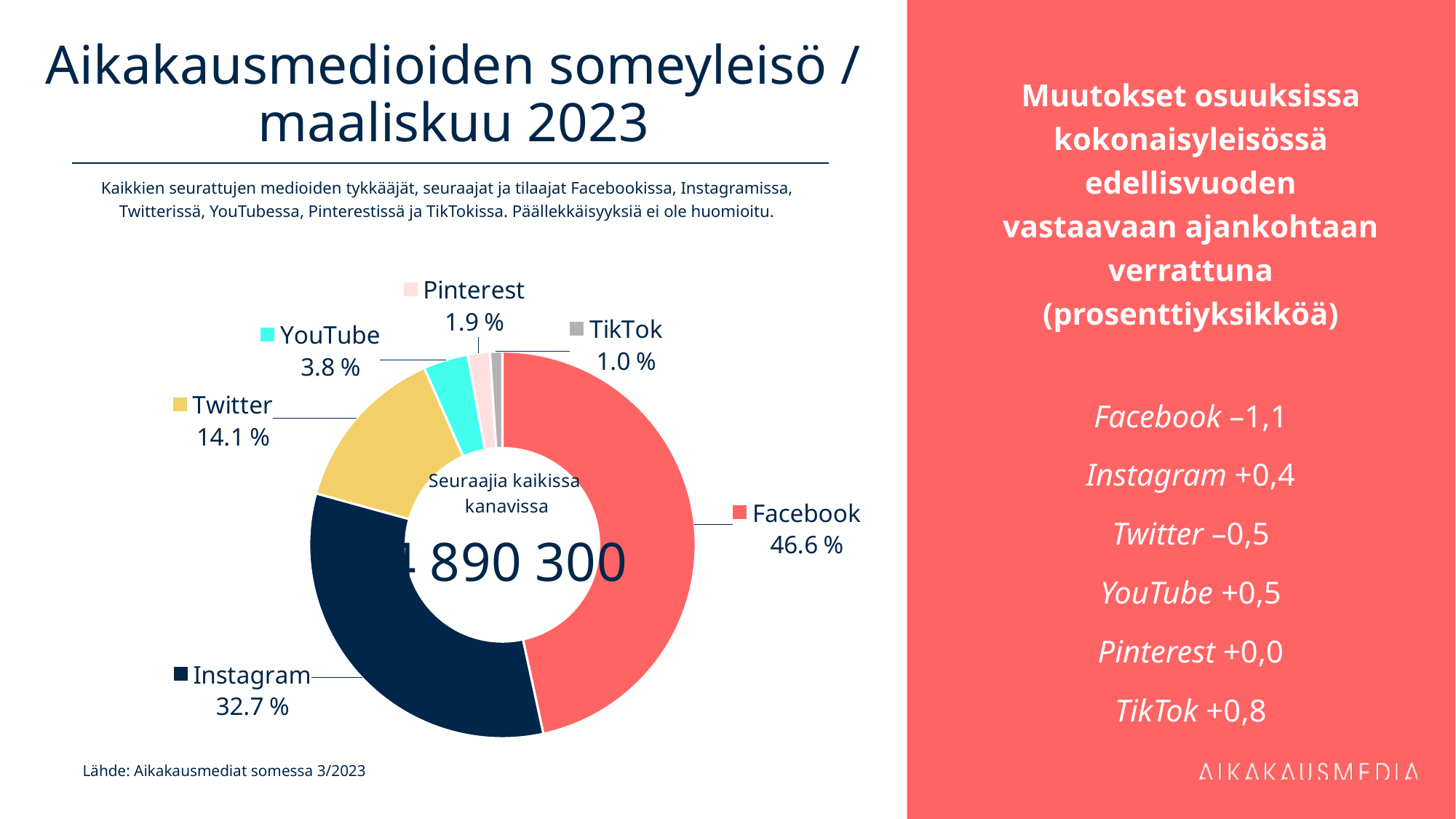
What is the value shown for YouTube? 3.8 % What colour is the Twitter slice in the chart? Yellow Which has a larger share, Twitter or YouTube? Twitter What is the value shown for Instagram in the chart? 32.7 % What percentage does TikTok have in the chart? 1.0 % How many platforms are shown in the chart? 6 How many percentage points larger is Facebook's share than Instagram's? 13.9 What share of the donut chart does Facebook account for? 46.6 % What percentage is shown for Twitter? 14.1 % What type of chart is shown on the slide? Donut (pie) chart Which platform has the largest slice of the chart? Facebook Which platform has the smallest slice of the chart? TikTok